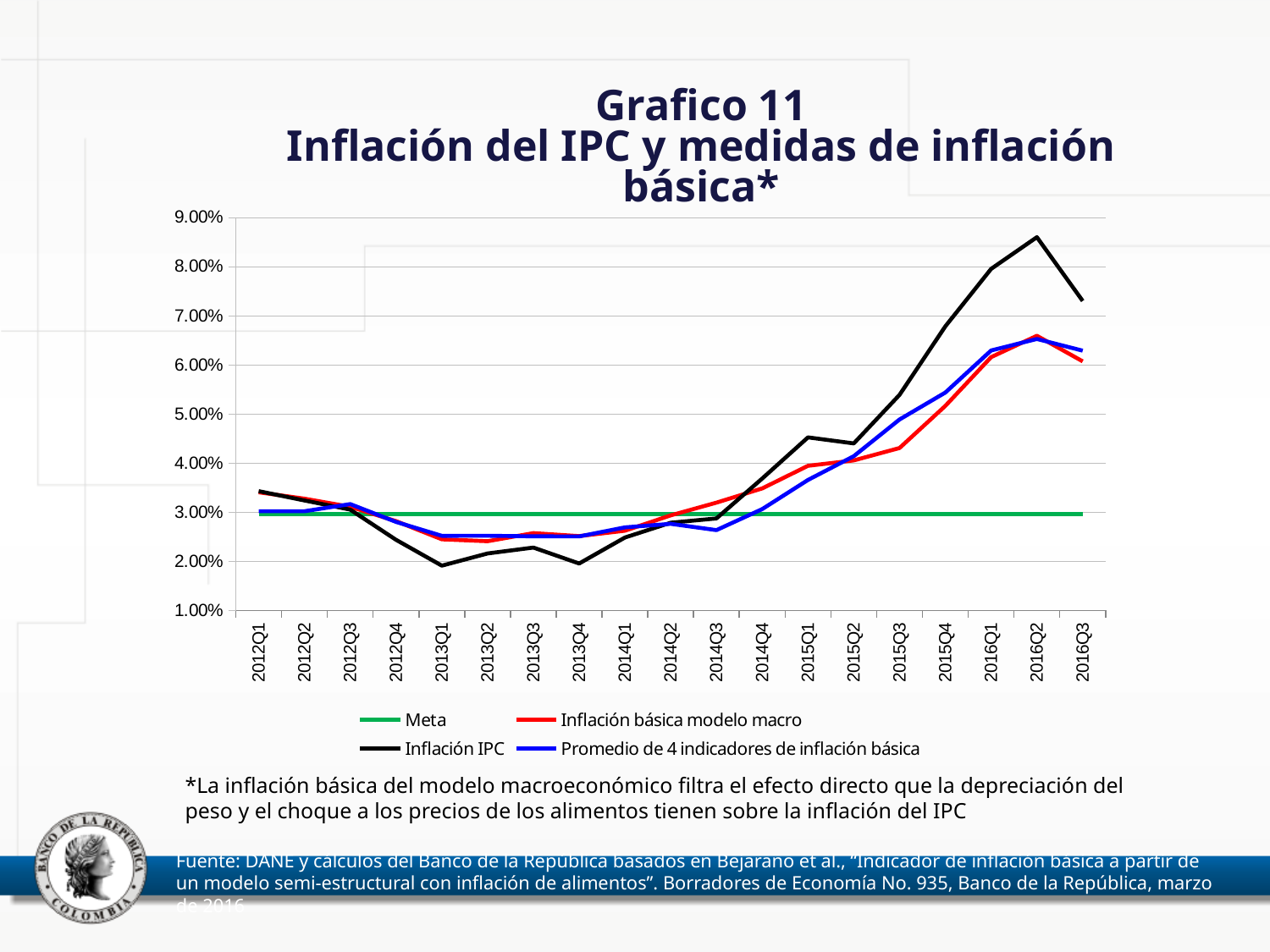
Is the value of Inflación IPC in 2016Q2 greater or less than 8.00%? greater Does Inflación IPC rise or fall between 2014Q1 and 2016Q2? rise Is the value of Promedio de 4 indicadores de inflación básica in 2016Q1 greater or less than 6.00%? greater In which quarter does Inflación IPC reach its highest value? 2016Q2 How many quarters are plotted along the x axis? 19 In 2016Q3, which is larger: Inflación IPC or Promedio de 4 indicadores de inflación básica? Inflación IPC What type of chart is shown on the slide? line chart How many series does the legend list? 4 In 2013Q1, which is larger: Meta or Inflación IPC? Meta What colour is the Meta line in the chart? green Is the value of Inflación IPC in 2015Q1 greater or less than 4.00%? greater